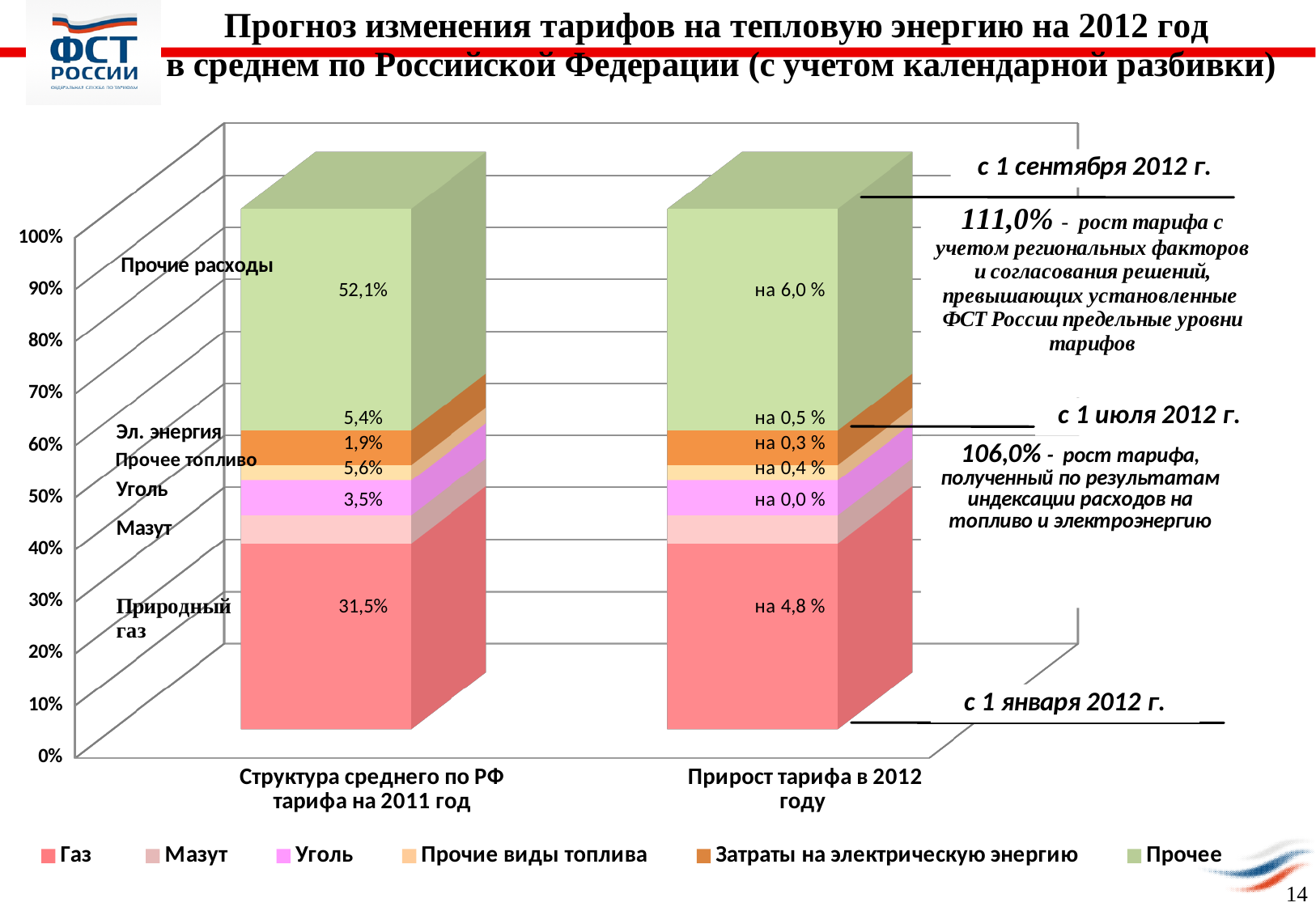
In the bar 'Структура среднего по РФ тарифа на 2011 год', which component has the largest share? Прочие расходы In the bar 'Структура среднего по РФ тарифа на 2011 год', what share is labelled for 'Прочие расходы'? 52,1% In the bar 'Структура среднего по РФ тарифа на 2011 год', what share is labelled for 'Уголь'? 5,6% In the bar 'Структура среднего по РФ тарифа на 2011 год', what share is labelled for 'Мазут'? 3,5% In the bar 'Прирост тарифа в 2012 году', what increase is labelled for the 'Газ' (red) segment? на 4,8 % Which legend entry is shown in green? Прочее What kind of chart is shown on the slide? Stacked bar chart In the bar 'Структура среднего по РФ тарифа на 2011 год', what is the difference between the shares of 'Прочие расходы' and 'Природный газ'? 20,6% In the bar 'Прирост тарифа в 2012 году', what increase is labelled for the 'Прочее' (green) segment? на 6,0 % In the bar 'Структура среднего по РФ тарифа на 2011 год', what share is labelled for 'Природный газ'? 31,5% How many series does the legend list? 6 How many bars (categories) are plotted on the x axis? 2